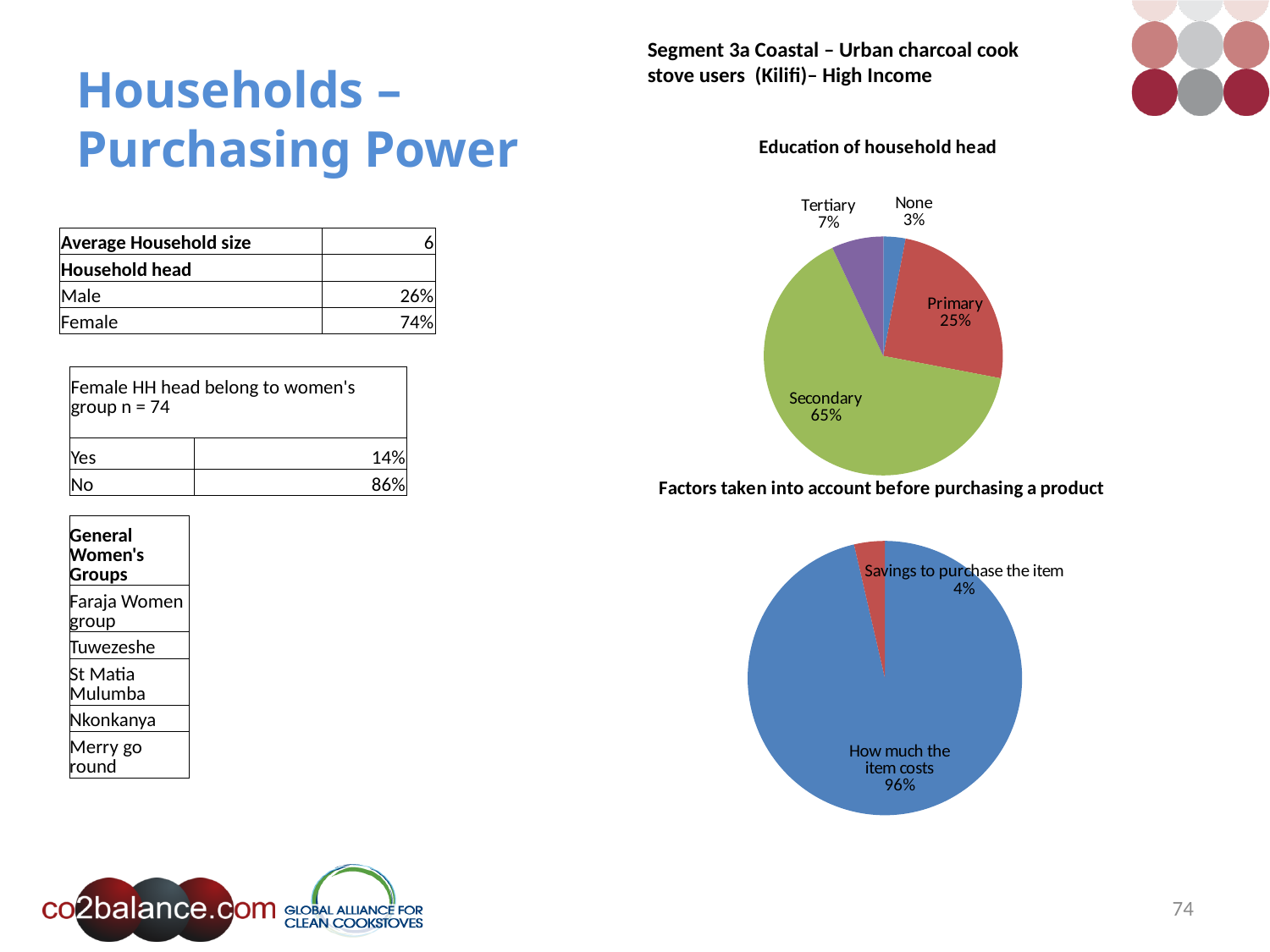
In the 'Education of household head' chart, which education level has the largest share? Secondary In the 'Factors taken into account before purchasing a product' chart, how many factors are shown? 2 In the 'Education of household head' chart, what share of household heads have primary education? 25% In the 'Factors taken into account before purchasing a product' chart, what share is 'How much the item costs'? 96% In the 'Education of household head' chart, what is the difference between the Secondary and Primary shares? 40 percentage points In the 'Factors taken into account before purchasing a product' chart, what share is 'Savings to purchase the item'? 4% What type of chart is the 'Education of household head' chart? Pie chart In the 'Education of household head' chart, which education level has the smallest share? None In the 'Factors taken into account before purchasing a product' chart, which factor has the larger share? How much the item costs In the 'Education of household head' chart, what share of household heads have secondary education? 65% In the 'Education of household head' chart, how many slices does the pie have? 4 In the 'Education of household head' chart, what share of household heads have tertiary education? 7%